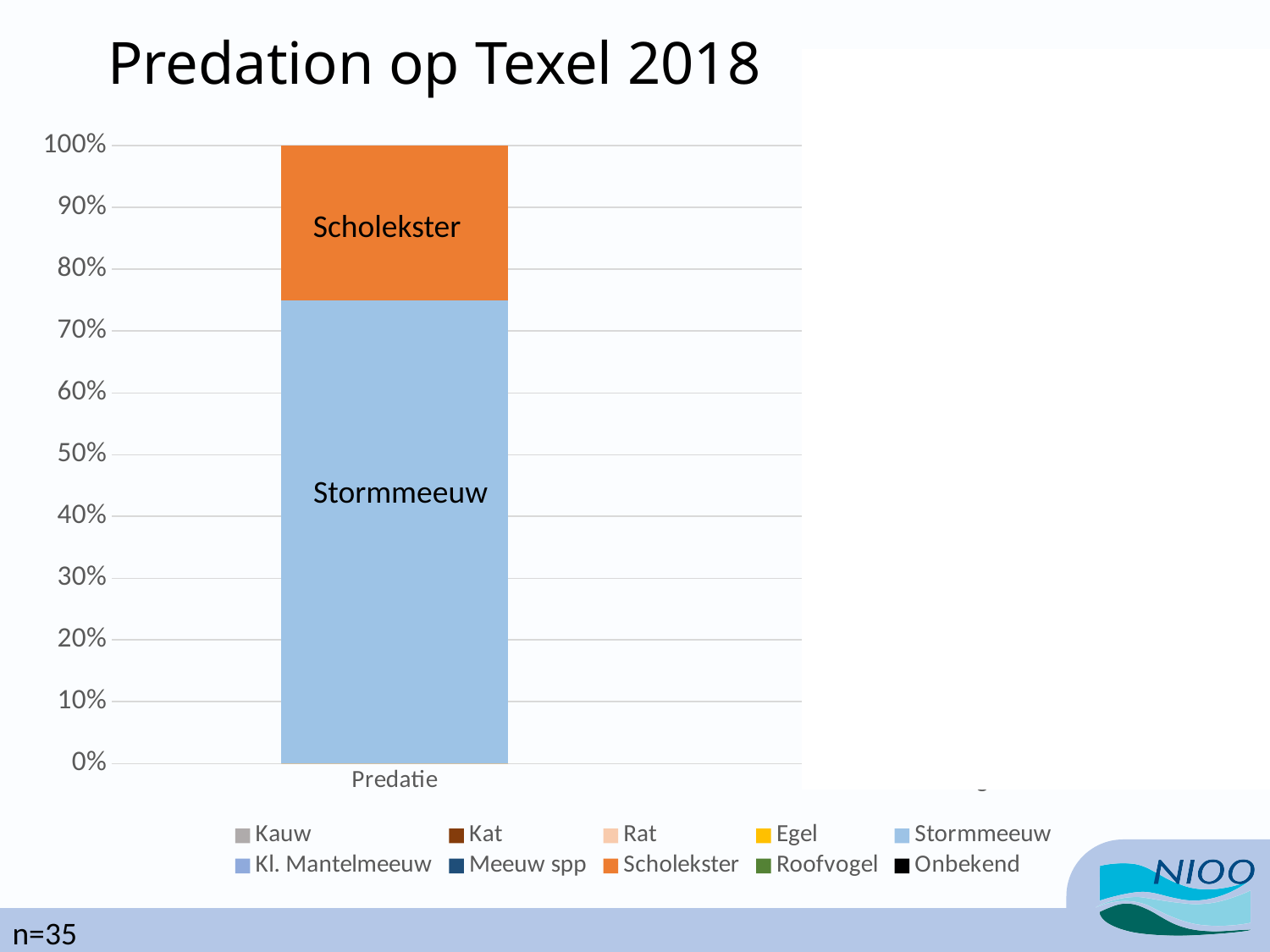
Which segment of the stacked bar is larger, Stormmeeuw or Scholekster? Stormmeeuw Is the value for Scholekster greater or less than 20%? greater Which series has the largest share of the Predatie bar? Stormmeeuw Is the value for Stormmeeuw greater or less than 80%? less How many categories are plotted on the x axis? 1 What colour is the Scholekster segment of the bar? orange How many series does the legend list? 10 Is the value for Stormmeeuw greater or less than 70%? greater What is the title of the chart? Predation op Texel 2018 What is the total height of the stacked Predatie bar? 100% What kind of chart is shown on the slide? bar chart